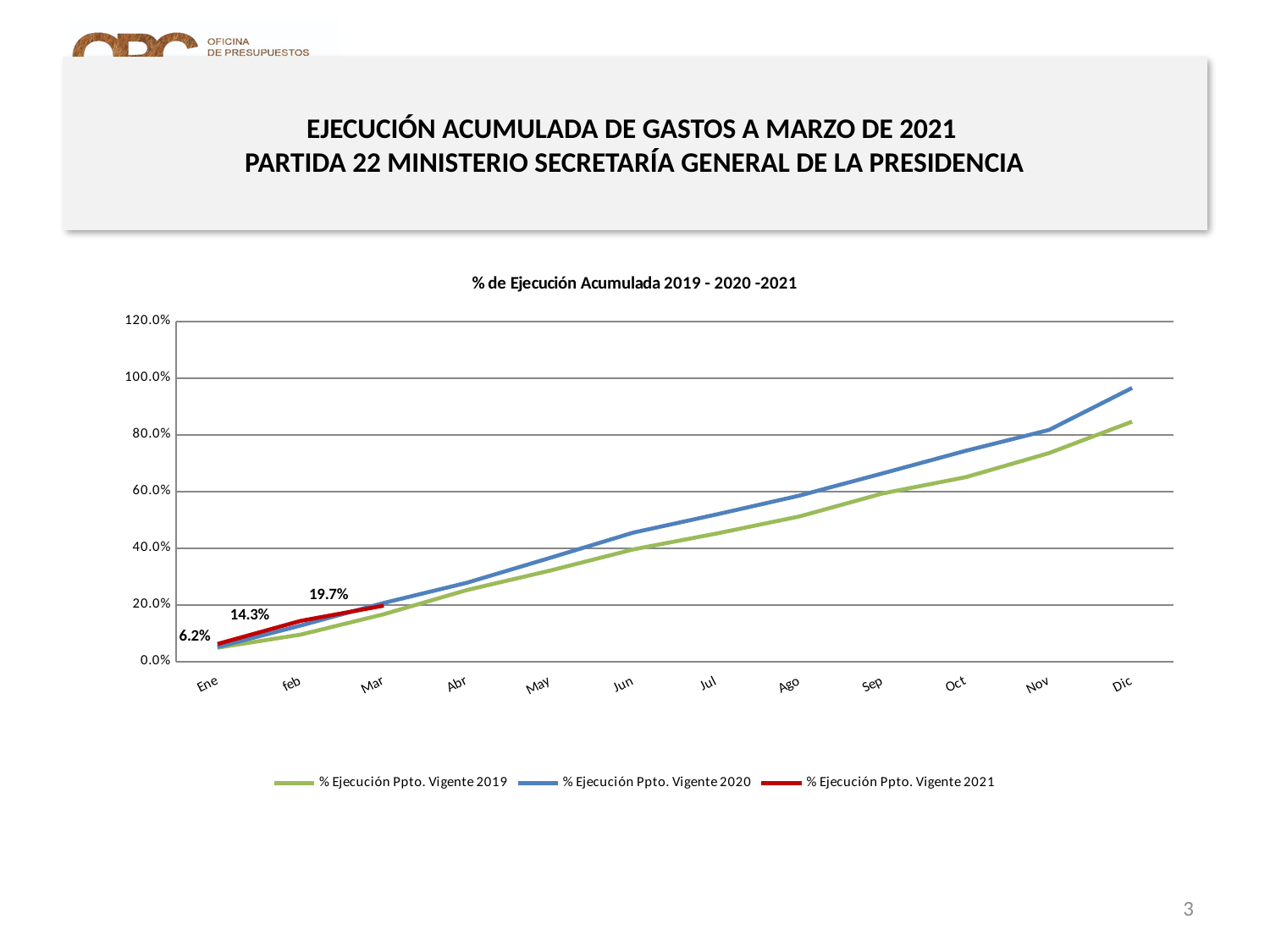
What type of chart is shown on the slide? Line chart What is the value of % Ejecución Ppto. Vigente 2021 in feb? 14.3% What is the value of % Ejecución Ppto. Vigente 2021 in Ene? 6.2% How many series does the chart legend list? 3 In which month does the % Ejecución Ppto. Vigente 2021 series reach its highest labelled value? Mar What is the value of % Ejecución Ppto. Vigente 2021 in Mar? 19.7% How many months are shown on the x axis of the chart? 12 By how many percentage points did % Ejecución Ppto. Vigente 2021 increase from Ene to feb? 8.1 Is the value of % Ejecución Ppto. Vigente 2020 in Dic greater or less than 80.0%? greater In Dic, which series is higher: % Ejecución Ppto. Vigente 2019 or % Ejecución Ppto. Vigente 2020? % Ejecución Ppto. Vigente 2020 By how many percentage points did % Ejecución Ppto. Vigente 2021 increase from feb to Mar? 5.4 Is the value of % Ejecución Ppto. Vigente 2019 in Jun greater or less than 60.0%? less